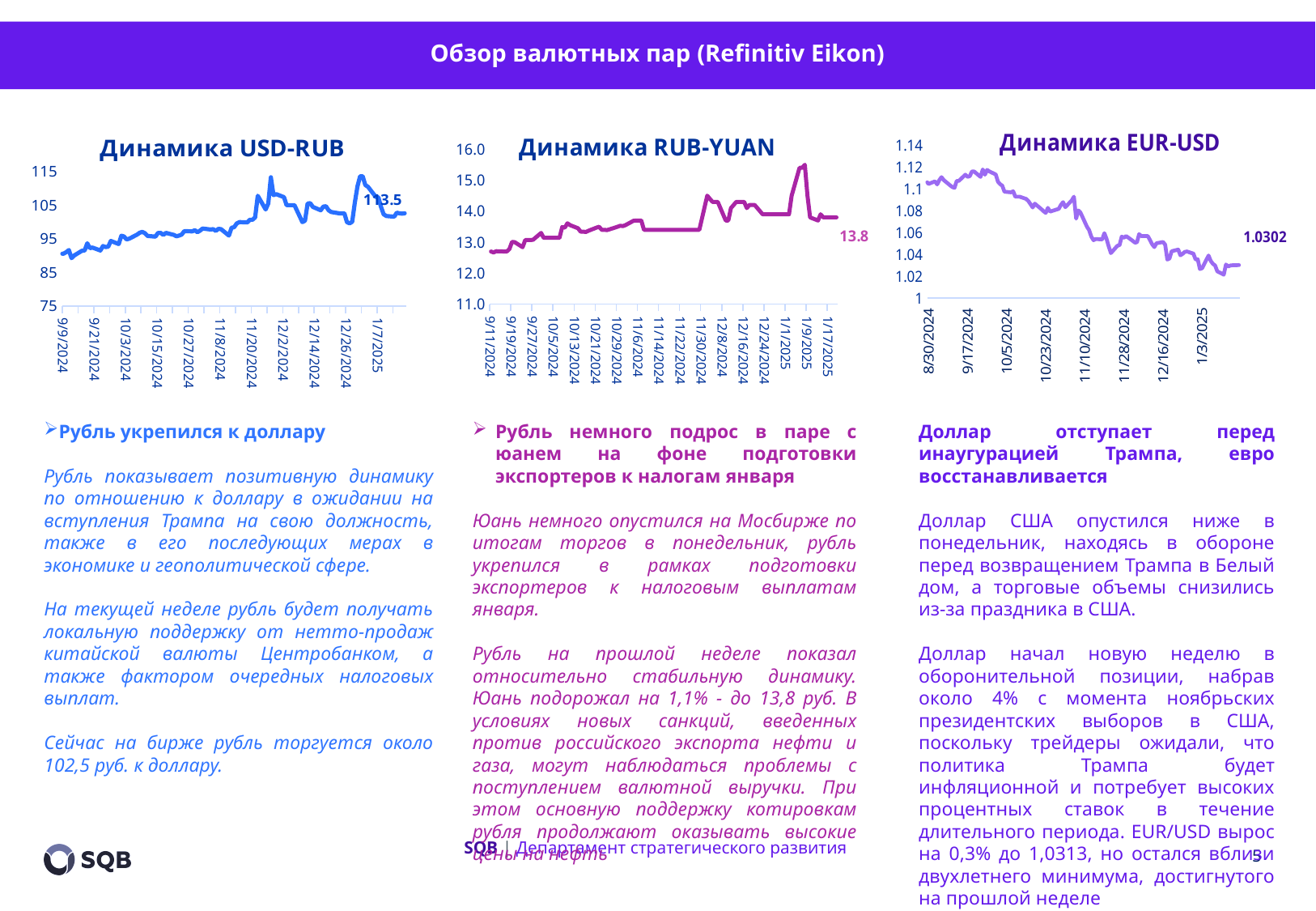
What kind of chart is the "Динамика USD-RUB" chart? line chart In the "Динамика EUR-USD" chart, do values generally rise or fall from left to right? fall In the "Динамика EUR-USD" chart, is the final value greater or less than 1.06? less What is the highest tick shown on the y axis of the "Динамика RUB-YUAN" chart? 16.0 What is the title of the rightmost chart on the slide? Динамика EUR-USD In the "Динамика EUR-USD" chart, what is the last labelled value? 1.0302 In the "Динамика USD-RUB" chart, is the peak value greater or less than 105? greater How many charts are shown on the slide? 3 In the "Динамика USD-RUB" chart, is the first value (9/9/2024) greater or less than 95? less In the "Динамика RUB-YUAN" chart, what is the last labelled value? 13.8 In the "Динамика USD-RUB" chart, do values generally rise or fall from 9/9/2024 to 1/7/2025? rise